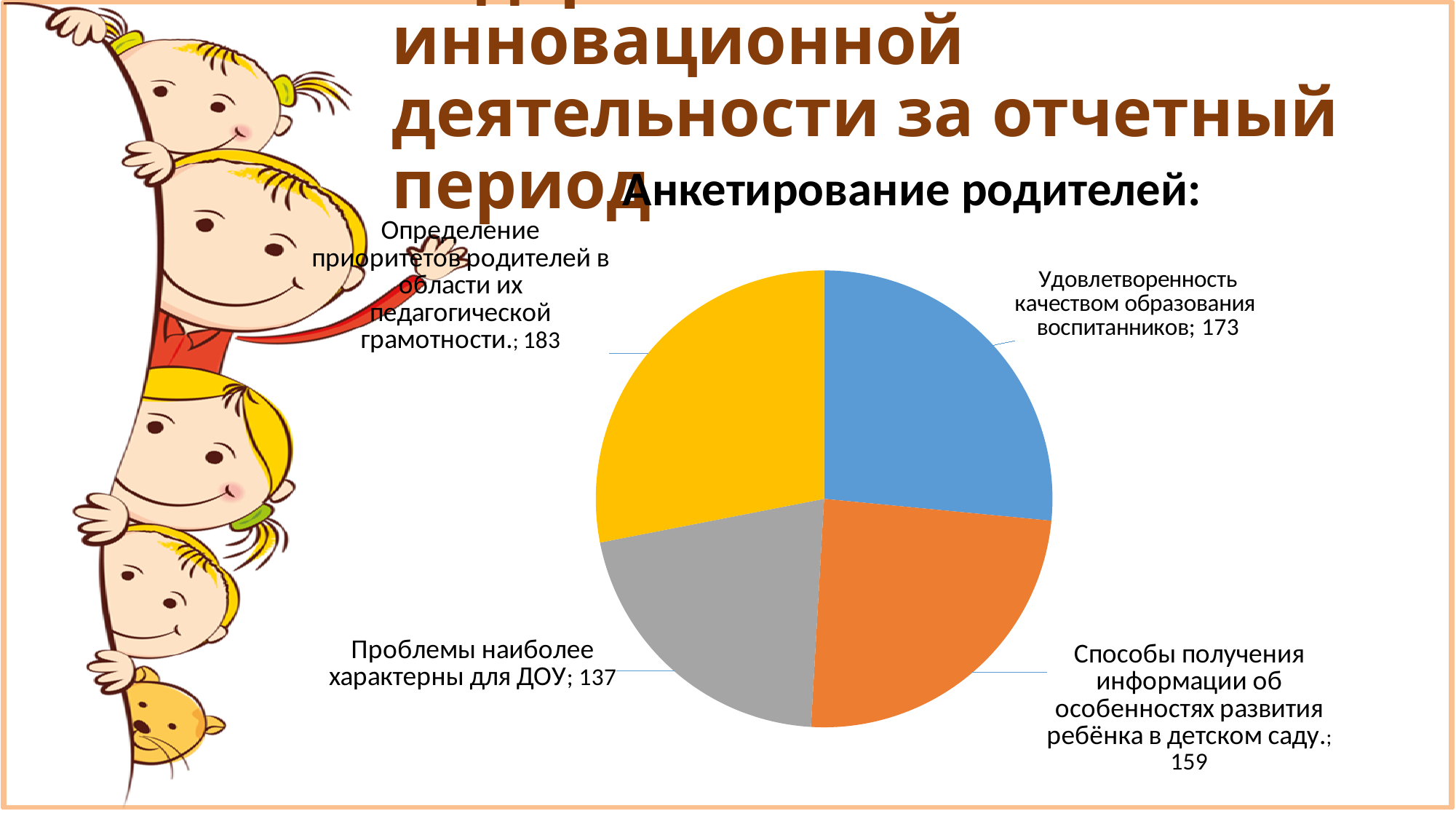
What is the title of the chart? Анкетирование родителей: How many slices does the pie chart have? 4 What is the value for "Способы получения информации об особенностях развития ребёнка в детском саду"? 159 What kind of chart is shown on the slide? pie chart Which category has the smallest value? Проблемы наиболее характерны для ДОУ What is the value for "Определение приоритетов родителей в области их педагогической грамотности"? 183 What is the difference between the values for "Определение приоритетов родителей в области их педагогической грамотности" and "Проблемы наиболее характерны для ДОУ"? 46 What is the value for "Проблемы наиболее характерны для ДОУ"? 137 What is the value for "Удовлетворенность качеством образования воспитанников"? 173 Which is larger: the value for "Удовлетворенность качеством образования воспитанников" or for "Способы получения информации об особенностях развития ребёнка в детском саду"? Удовлетворенность качеством образования воспитанников Which category has the largest value? Определение приоритетов родителей в области их педагогической грамотности What colour is the slice for "Проблемы наиболее характерны для ДОУ"? gray